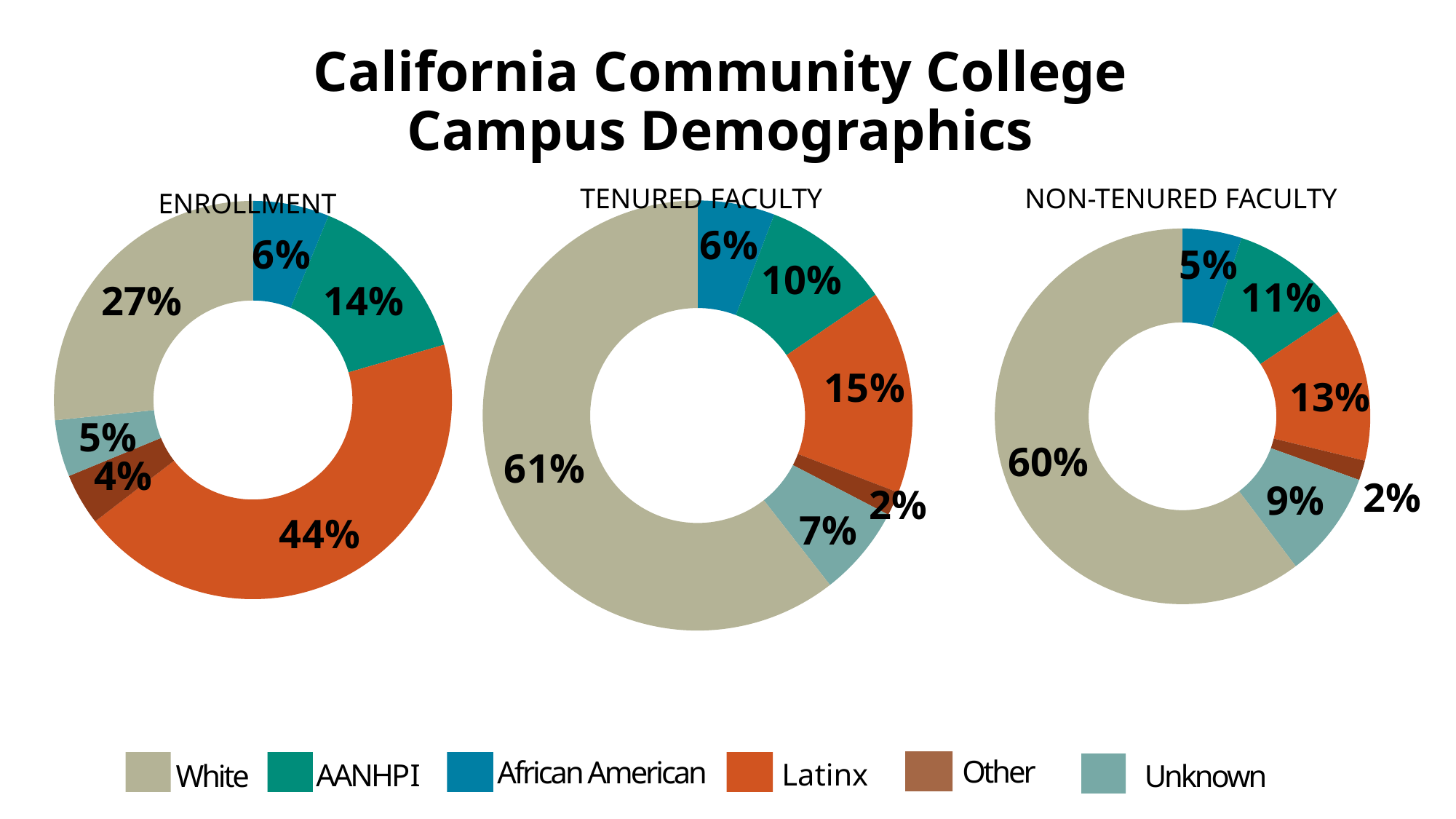
In the NON-TENURED FACULTY chart, which group has the largest share? White In the ENROLLMENT chart, what is the difference between the AANHPI share and the African American share? 8% How many groups does the legend list? 6 In the TENURED FACULTY chart, which group has the smallest share? Other What is the difference between the White share in the TENURED FACULTY chart and the White share in the ENROLLMENT chart? 34% What is the title of the slide's chart set? California Community College Campus Demographics In the TENURED FACULTY chart, what share is White? 61% In the NON-TENURED FACULTY chart, which is larger, the AANHPI share or the Latinx share? Latinx What kind of chart is used for TENURED FACULTY? Pie (donut) chart In the ENROLLMENT chart, which group has the largest share? Latinx In the ENROLLMENT chart, what share is Latinx? 44% In the NON-TENURED FACULTY chart, what share is Unknown? 9%